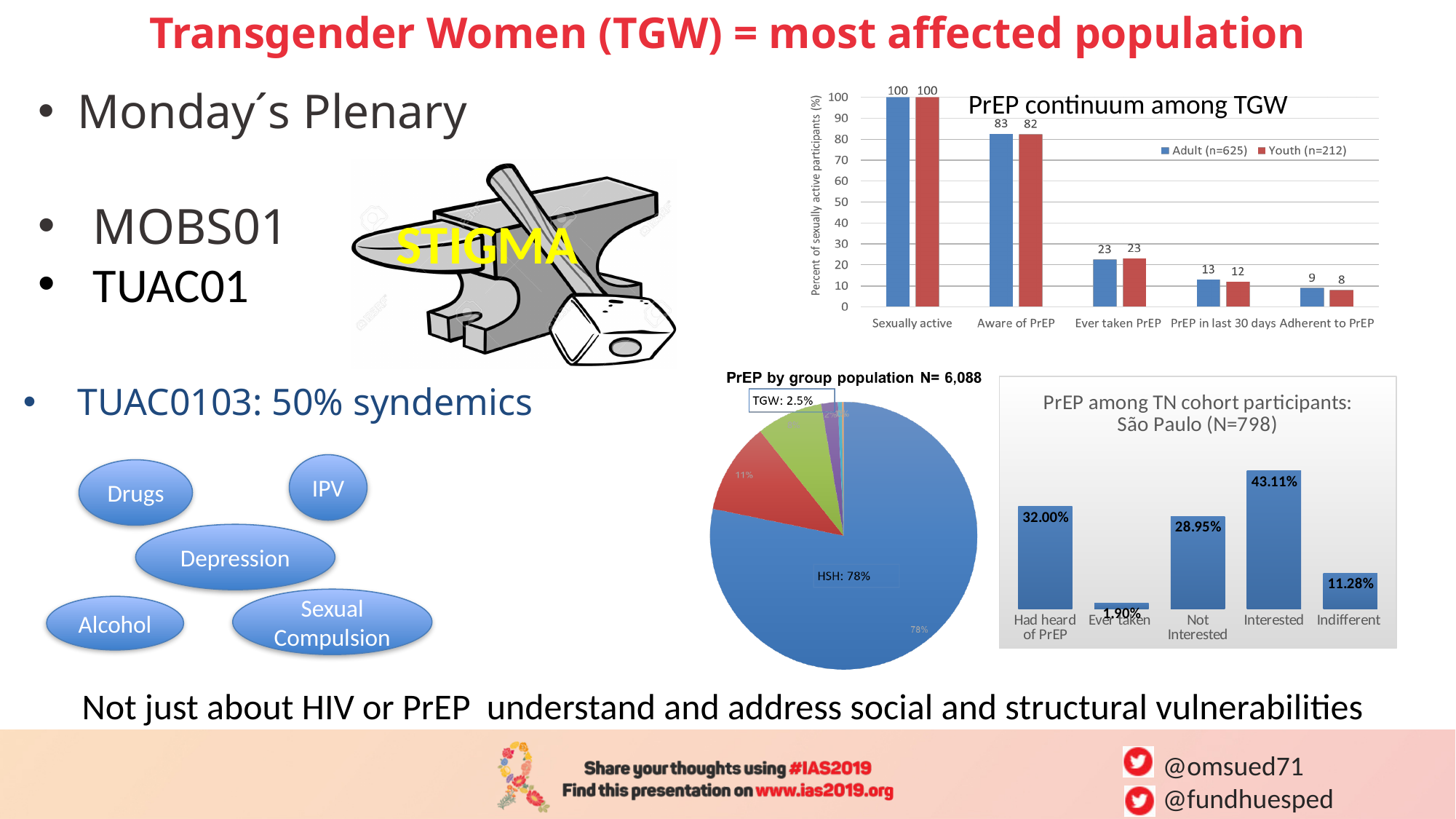
In the 'PrEP among TN cohort participants: São Paulo (N=798)' chart, which category has the highest value? Interested In the 'PrEP continuum among TGW' chart, how many categories are shown on the x axis? 5 In the 'PrEP by group population N= 6,088' chart, what share of the pie is HSH? 78% In the 'PrEP continuum among TGW' chart, what is the difference between the Adult and Youth values for 'PrEP in last 30 days'? 1 In the 'PrEP continuum among TGW' chart, how many series does the legend list? 2 What kind of chart is 'PrEP by group population N= 6,088'? pie chart In the 'PrEP by group population N= 6,088' chart, what share of the pie is TGW? 2.5% In the 'PrEP continuum among TGW' chart, what is the value for Adult (n=625) in the 'Aware of PrEP' category? 83 In the 'PrEP continuum among TGW' chart, what is the value for Youth (n=212) in the 'Adherent to PrEP' category? 8 In the 'PrEP among TN cohort participants: São Paulo (N=798)' chart, which is larger, 'Had heard of PrEP' or 'Not Interested'? Had heard of PrEP In the 'PrEP continuum among TGW' chart, do the values rise or fall moving from left to right along the x axis? fall In the 'PrEP among TN cohort participants: São Paulo (N=798)' chart, what is the value for 'Ever taken'? 1.90%